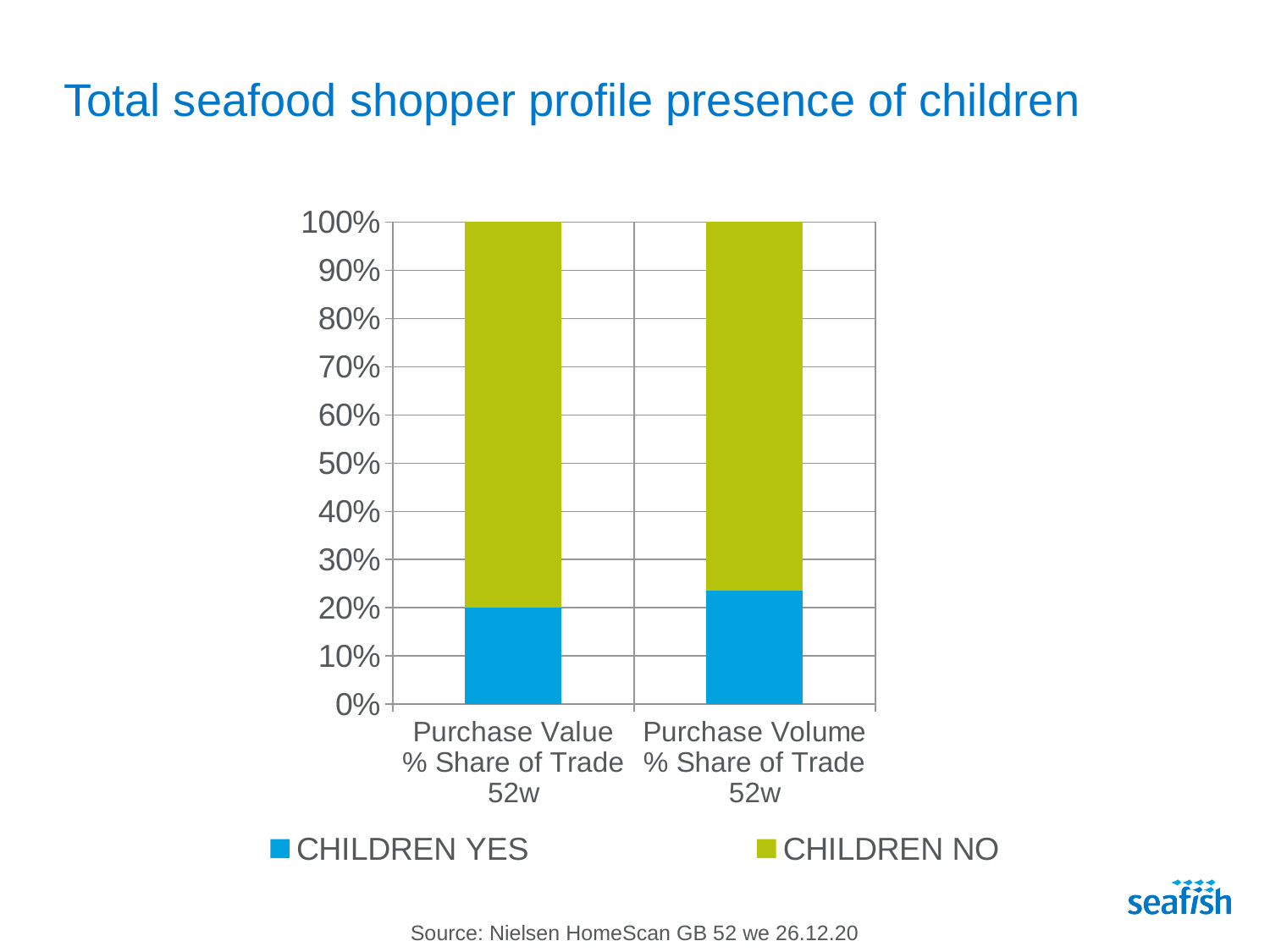
Is the CHILDREN NO share for Purchase Value % Share of Trade 52w greater or less than 70%? greater How many series does the legend list? 2 How many categories are shown on the x axis? 2 Which series makes up the larger part of each bar? CHILDREN NO Which series is shown in blue? CHILDREN YES Is the CHILDREN YES value for Purchase Value % Share of Trade 52w greater or less than 30%? less Is the CHILDREN YES value for Purchase Volume % Share of Trade 52w greater or less than 20%? greater What kind of chart is shown on the slide? Stacked bar chart What is the total of the stacked bar for Purchase Value % Share of Trade 52w? 100% Which series is shown in green? CHILDREN NO Which category has the larger CHILDREN YES share, Purchase Value % Share of Trade 52w or Purchase Volume % Share of Trade 52w? Purchase Volume % Share of Trade 52w